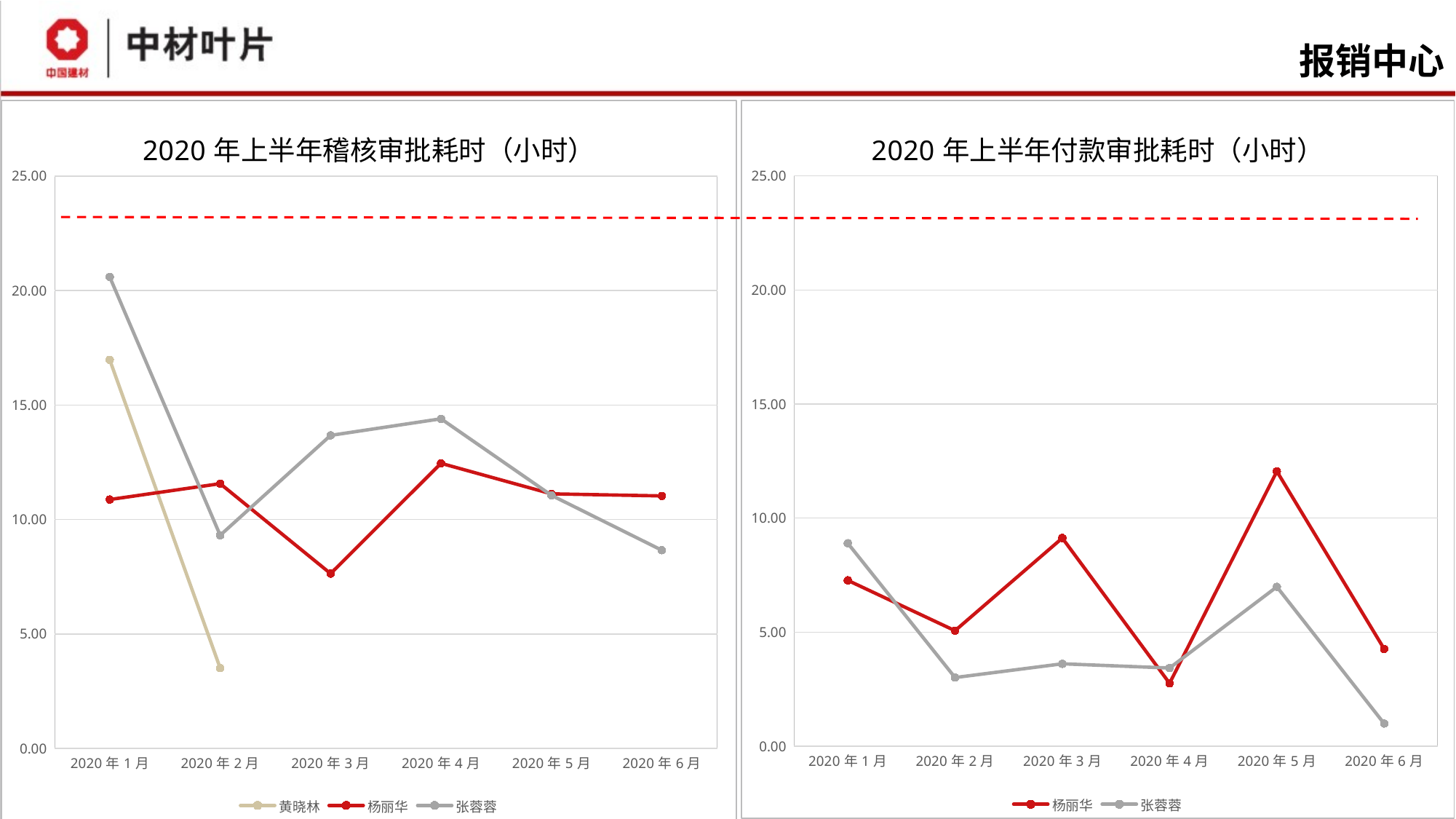
In the left chart (2020 年上半年稽核审批耗时), is the value for 张蓉蓉 in 2020 年 1 月 greater or less than 20.00? greater In the right chart (2020 年上半年付款审批耗时), is the value for 杨丽华 in 2020 年 5 月 greater or less than 10.00? greater What kind of chart is the left chart titled 2020 年上半年稽核审批耗时（小时）? line chart In the right chart (2020 年上半年付款审批耗时), in which month does 杨丽华 have the highest value? 2020 年 5 月 In the left chart (2020 年上半年稽核审批耗时), in which month does 杨丽华 have the lowest value? 2020 年 3 月 In the right chart (2020 年上半年付款审批耗时), which series has the higher value in 2020 年 3 月, 杨丽华 or 张蓉蓉? 杨丽华 How many series does the legend of the right chart (2020 年上半年付款审批耗时) list? 2 In the left chart (2020 年上半年稽核审批耗时), is the value for 黄晓林 in 2020 年 2 月 greater or less than 5.00? less In the right chart (2020 年上半年付款审批耗时), does the value for 张蓉蓉 rise or fall from 2020 年 5 月 to 2020 年 6 月? fall In the left chart (2020 年上半年稽核审批耗时), which series has the higher value in 2020 年 4 月, 杨丽华 or 张蓉蓉? 张蓉蓉 How many months are shown on the x axis of the right chart (2020 年上半年付款审批耗时)? 6 How many series does the legend of the left chart (2020 年上半年稽核审批耗时) list? 3